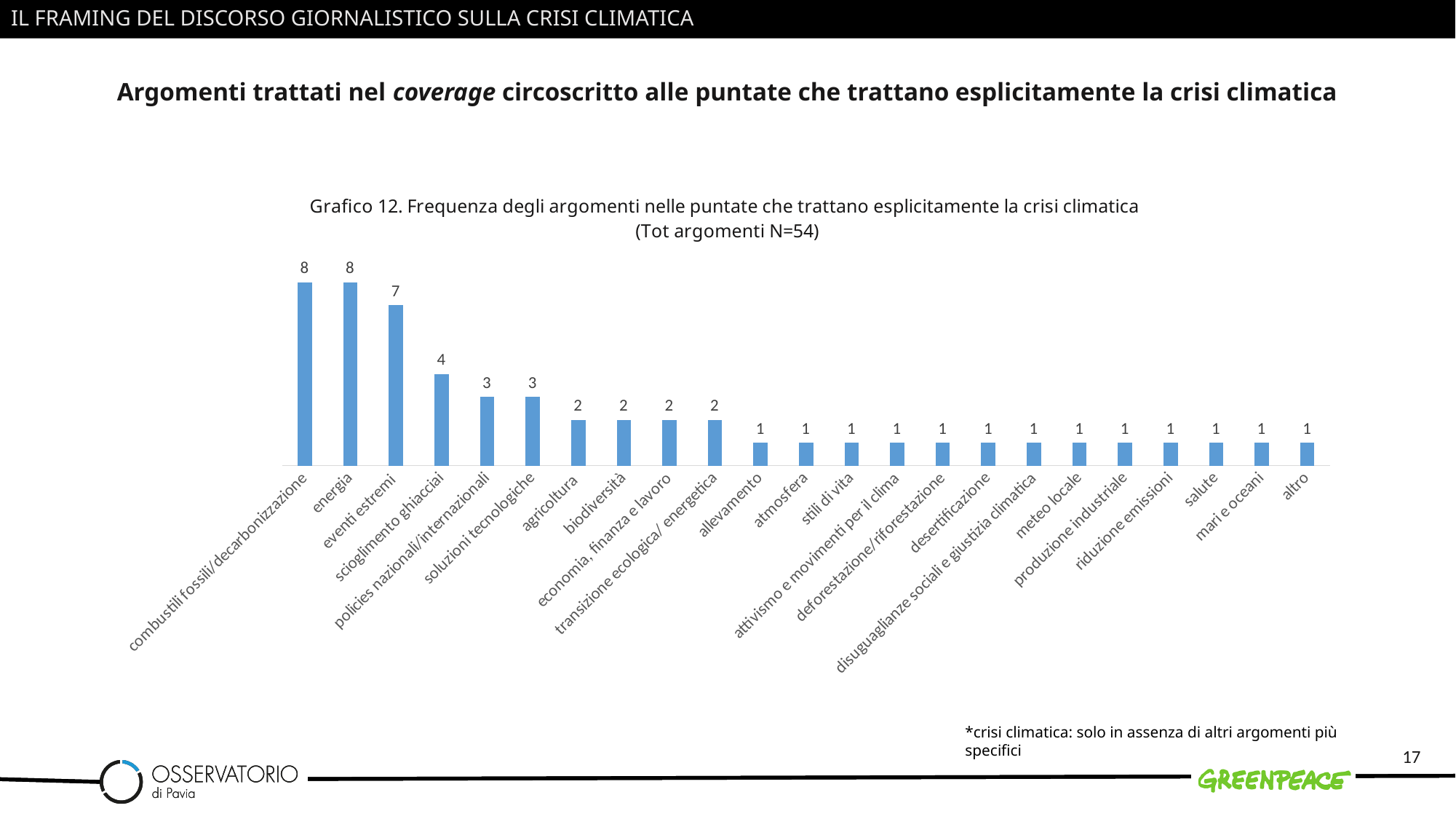
What is the value for eventi estremi? 7 What is the value for soluzioni tecnologiche? 3 Which is larger, the value for policies nazionali/internazionali or the value for agricoltura? policies nazionali/internazionali Do the values rise or fall from left to right along the x axis? fall What is the difference between the values for eventi estremi and scioglimento ghiacciai? 3 What kind of chart is shown on the slide? bar chart What is the value for biodiversità? 2 What is the value for scioglimento ghiacciai? 4 How many categories are shown in the chart? 23 What is the value for energia? 8 What is the highest value shown in the chart? 8 What total number of argomenti (N) is stated in the chart title? 54